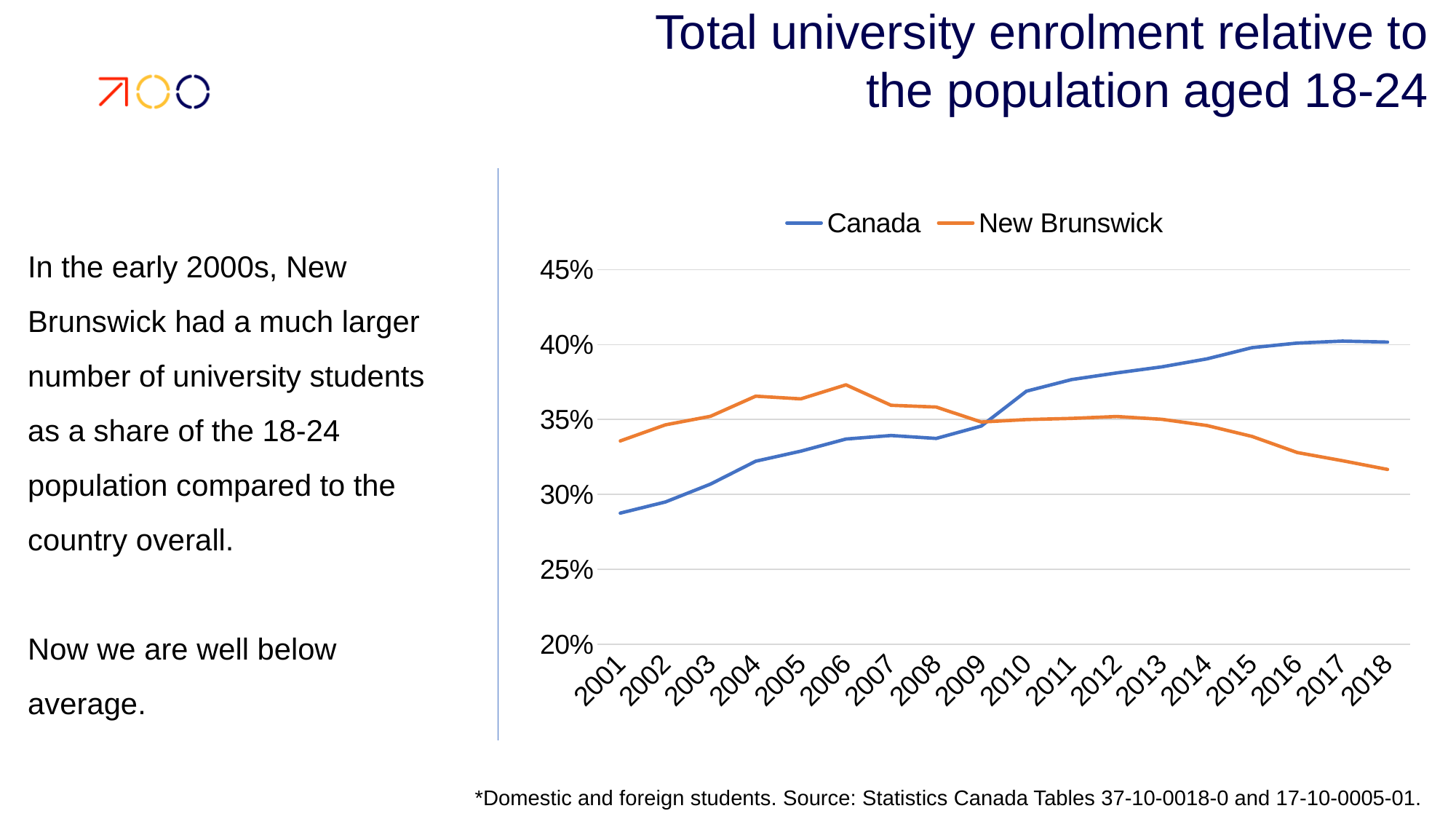
Is the value for New Brunswick in 2018 greater or less than 35%? less Is the value for Canada in 2001 greater or less than 30%? less How many series does the legend list? 2 Does the Canada series generally rise or fall from 2001 to 2018? rise Is the value for New Brunswick in 2006 greater or less than 35%? greater What kind of chart is shown on the slide? line chart How many years are shown on the x axis? 18 Which series is shown in orange? New Brunswick Does the New Brunswick series rise or fall from 2012 to 2018? fall Which series has the higher value in 2016, Canada or New Brunswick? Canada Which series has the higher value in 2004, Canada or New Brunswick? New Brunswick